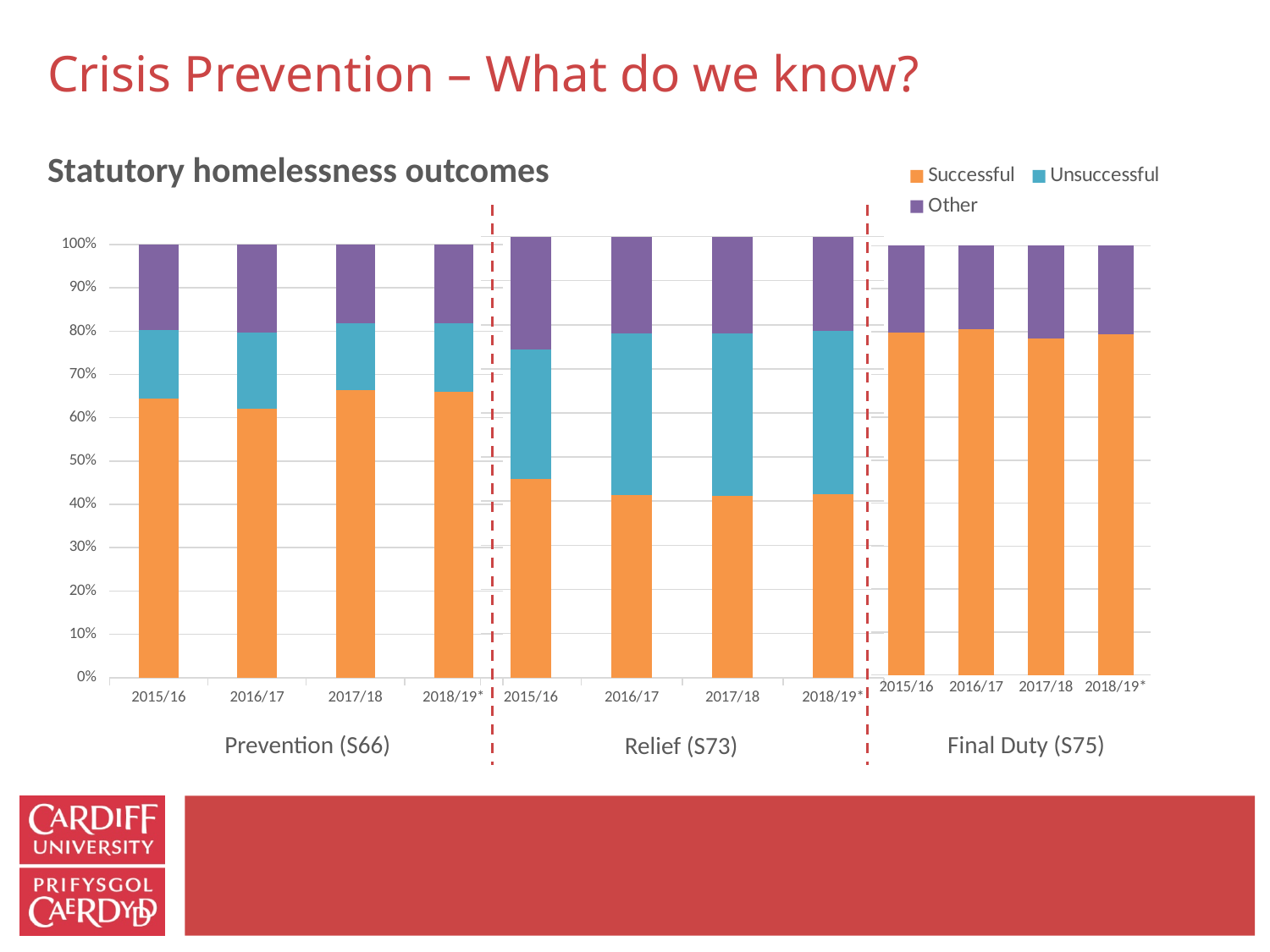
Which group has the lowest Successful share in 2017/18? Relief (S73) Is the Successful share for Relief (S73) in 2016/17 greater or less than 50%? less What is the title of the chart? Statutory homelessness outcomes In 2015/16, is the Successful share larger for Prevention (S66) or for Relief (S73)? Prevention (S66) Is the Successful share for Prevention (S66) in 2015/16 greater or less than 60%? greater What kind of chart is shown on the slide? Stacked bar chart How many bars are plotted in total across the three groups? 12 How many series does the legend list? 3 Which colour represents the Successful series in the legend? Orange How many years are shown for the Relief (S73) group? 4 Is the Successful share for Final Duty (S75) in 2017/18 greater or less than 70%? greater Which group has the highest Successful share in 2015/16: Prevention (S66), Relief (S73) or Final Duty (S75)? Final Duty (S75)